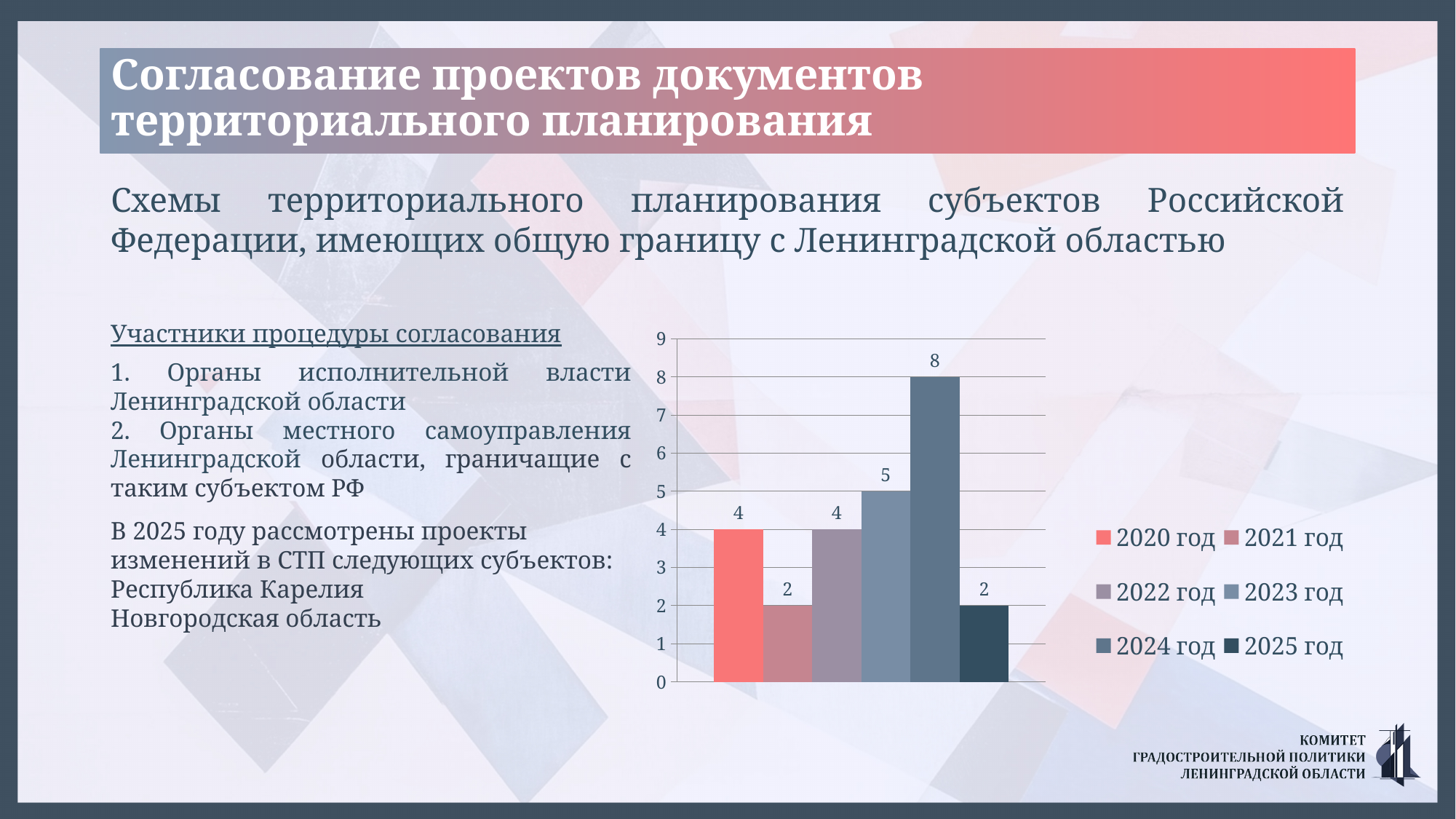
Which year has the highest value? 2024 год What is the value for 2021 год? 2 What is the value for 2025 год? 2 What is the value for 2023 год? 5 What kind of chart is shown on the slide? Bar chart How many series does the legend list? 6 What is the difference between the values for 2024 год and 2023 год? 3 What is the highest value shown on the vertical axis? 9 What is the difference between the values for 2020 год and 2021 год? 2 What is the value for 2020 год? 4 Which is larger, the value for 2023 год or the value for 2022 год? 2023 год What is the value for 2024 год? 8